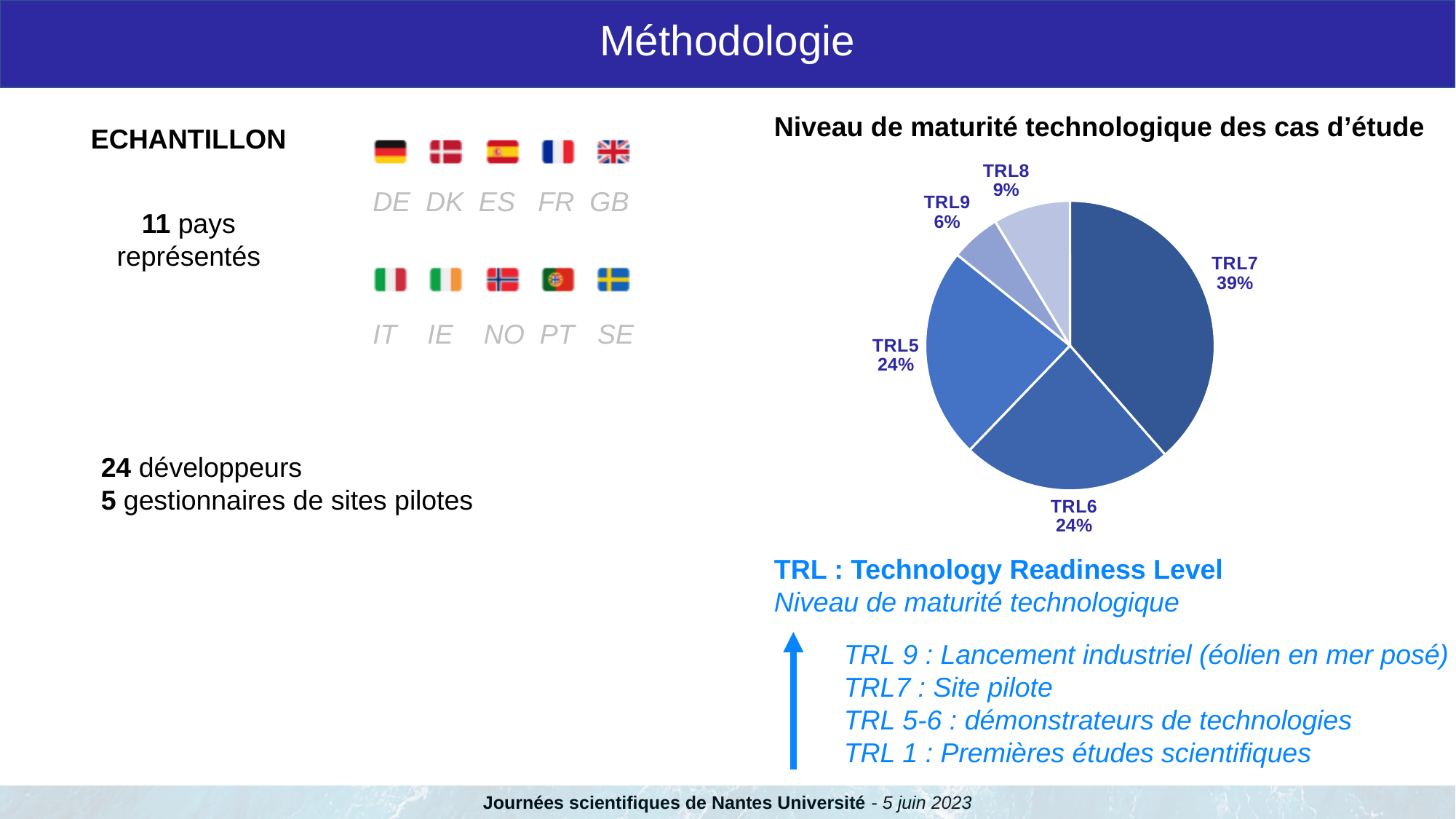
What share of the pie chart does TRL8 represent? 9% Which TRL level has the largest slice in the pie chart? TRL7 What is the title of the pie chart? Niveau de maturité technologique des cas d'étude What share of the pie chart does TRL7 represent? 39% Which slice is larger in the pie chart, TRL8 or TRL9? TRL8 What kind of chart is shown under the title 'Niveau de maturité technologique des cas d'étude'? pie chart What share of the pie chart does TRL9 represent? 6% Which TRL level has the smallest slice in the pie chart? TRL9 How many slices does the pie chart have? 5 What is the combined share of the TRL5 and TRL6 slices in the pie chart? 48% What is the difference in percentage points between the TRL7 slice and the TRL5 slice? 15 Which two TRL levels have equal shares in the pie chart? TRL5 and TRL6